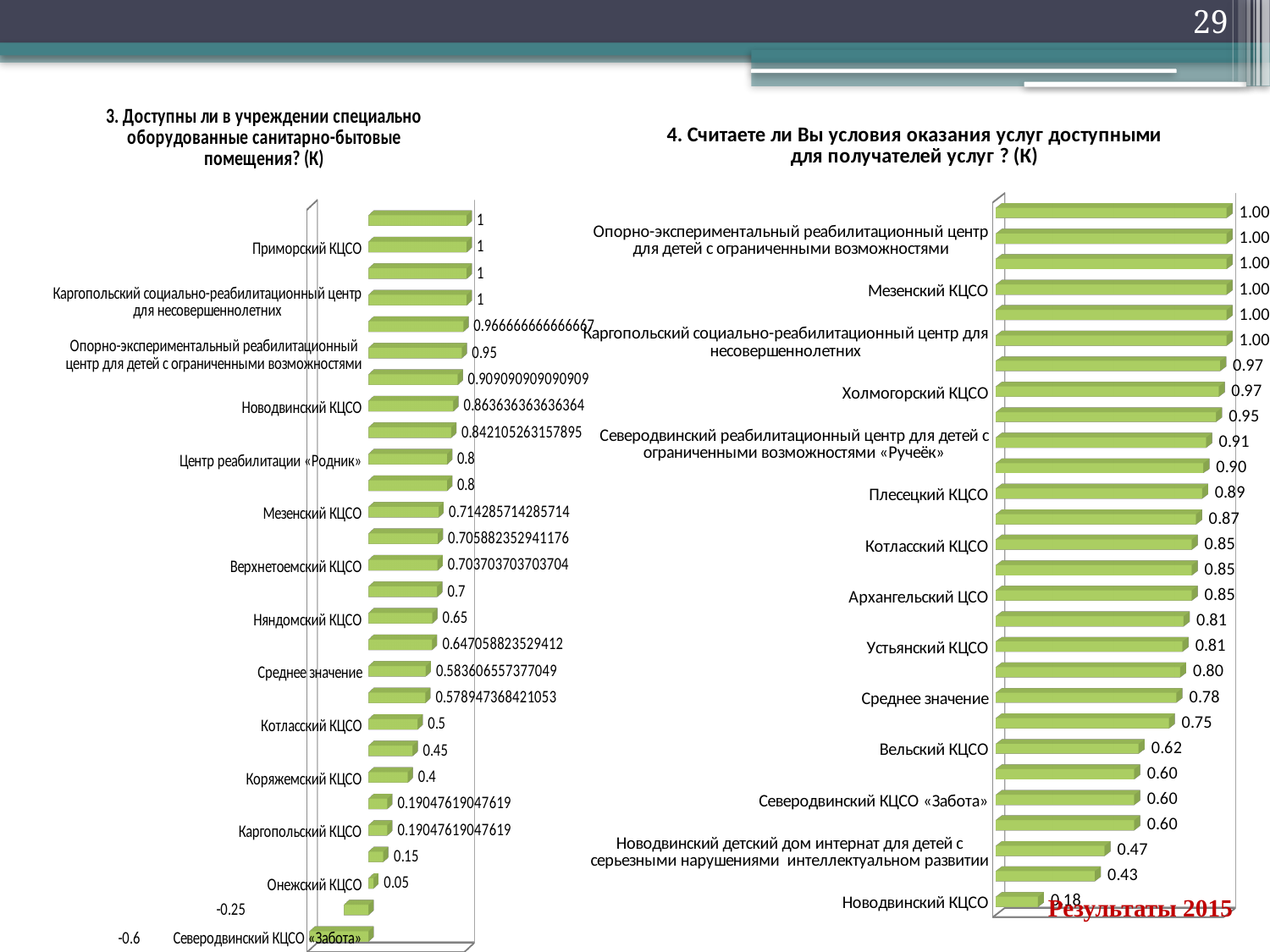
In the chart "4. Считаете ли Вы условия оказания услуг доступными для получателей услуг ? (К)", do the values rise or fall going from the top bar to the bottom bar? Fall In the chart "4. Считаете ли Вы условия оказания услуг доступными для получателей услуг ? (К)", which category has the lowest value? Новодвинский КЦСО In the chart "3. Доступны ли в учреждении специально оборудованные санитарно-бытовые помещения? (К)", which category has the lowest value? Северодвинский КЦСО «Забота» In the chart "4. Считаете ли Вы условия оказания услуг доступными для получателей услуг ? (К)", which is larger: Плесецкий КЦСО or Устьянский КЦСО? Плесецкий КЦСО In the chart "3. Доступны ли в учреждении специально оборудованные санитарно-бытовые помещения? (К)", what is the value for Онежский КЦСО? 0.05 In the chart "4. Считаете ли Вы условия оказания услуг доступными для получателей услуг ? (К)", what is the difference between Вельский КЦСО and Новодвинский КЦСО? 0.44 In the chart "4. Считаете ли Вы условия оказания услуг доступными для получателей услуг ? (К)", what is the value for Среднее значение? 0.78 In the chart "4. Считаете ли Вы условия оказания услуг доступными для получателей услуг ? (К)", what is the value for Вельский КЦСО? 0.62 In the chart "3. Доступны ли в учреждении специально оборудованные санитарно-бытовые помещения? (К)", what is the value for Котласский КЦСО? 0.5 In the chart "4. Считаете ли Вы условия оказания услуг доступными для получателей услуг ? (К)", what is the value for Новодвинский КЦСО? 0.18 What kind of chart is used for "4. Считаете ли Вы условия оказания услуг доступными для получателей услуг ? (К)"? Bar chart How many bars are plotted in the chart "4. Считаете ли Вы условия оказания услуг доступными для получателей услуг ? (К)"? 28